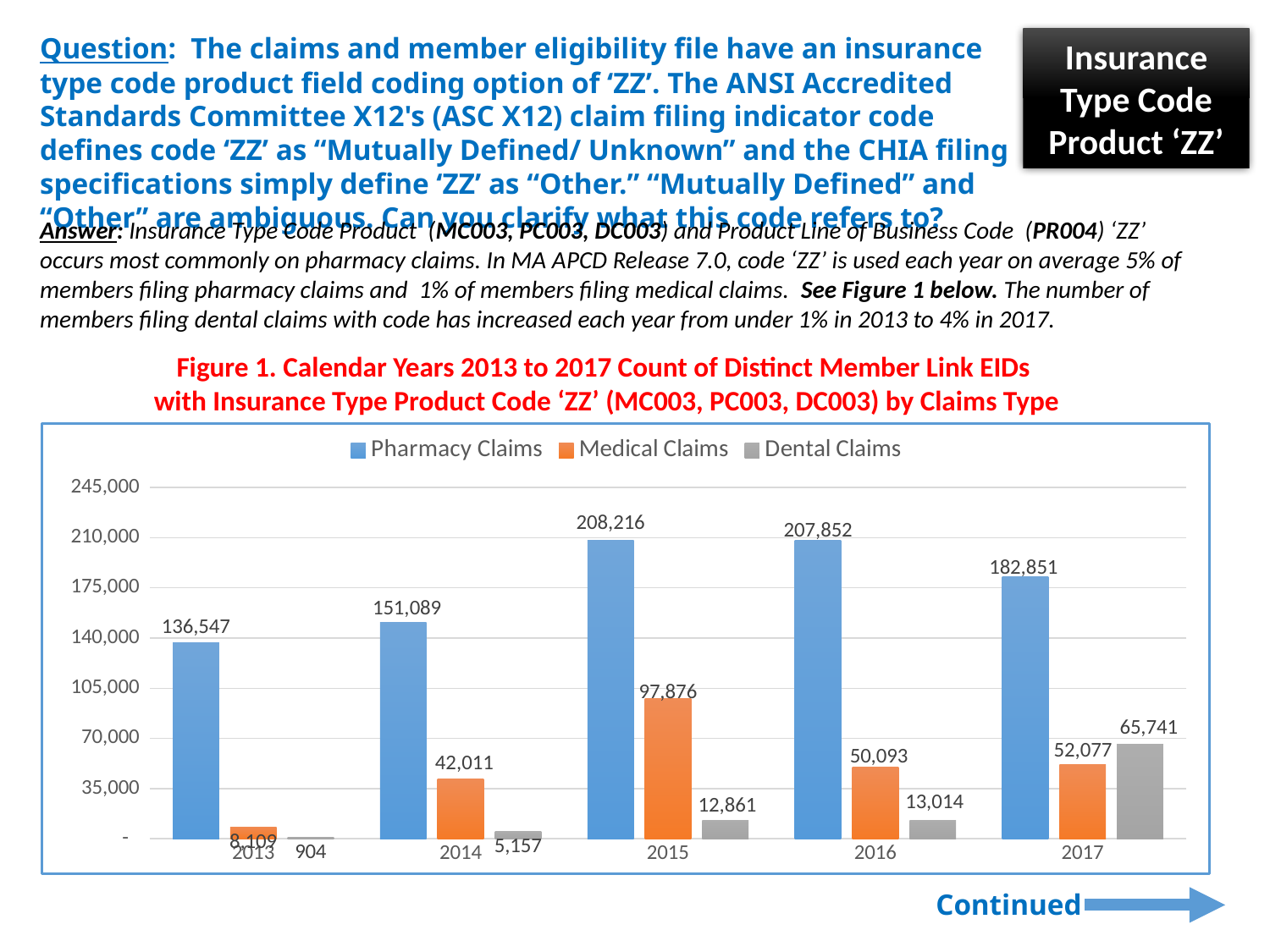
What is the value for Medical Claims in 2014? 42,011 In 2017, which is larger: Medical Claims or Dental Claims? Dental Claims What kind of chart is shown? bar chart What is the value for Pharmacy Claims in 2015? 208,216 In which year is the Dental Claims value lowest? 2013 In which year is the Medical Claims value highest? 2015 What is the value for Dental Claims in 2017? 65,741 How many series does the legend list? 3 What is the difference between the Medical Claims values for 2017 and 2016? 1,984 How many years are shown on the x axis? 5 What is the difference between the Pharmacy Claims values for 2015 and 2016? 364 Do the Dental Claims values rise or fall from 2013 to 2017? rise